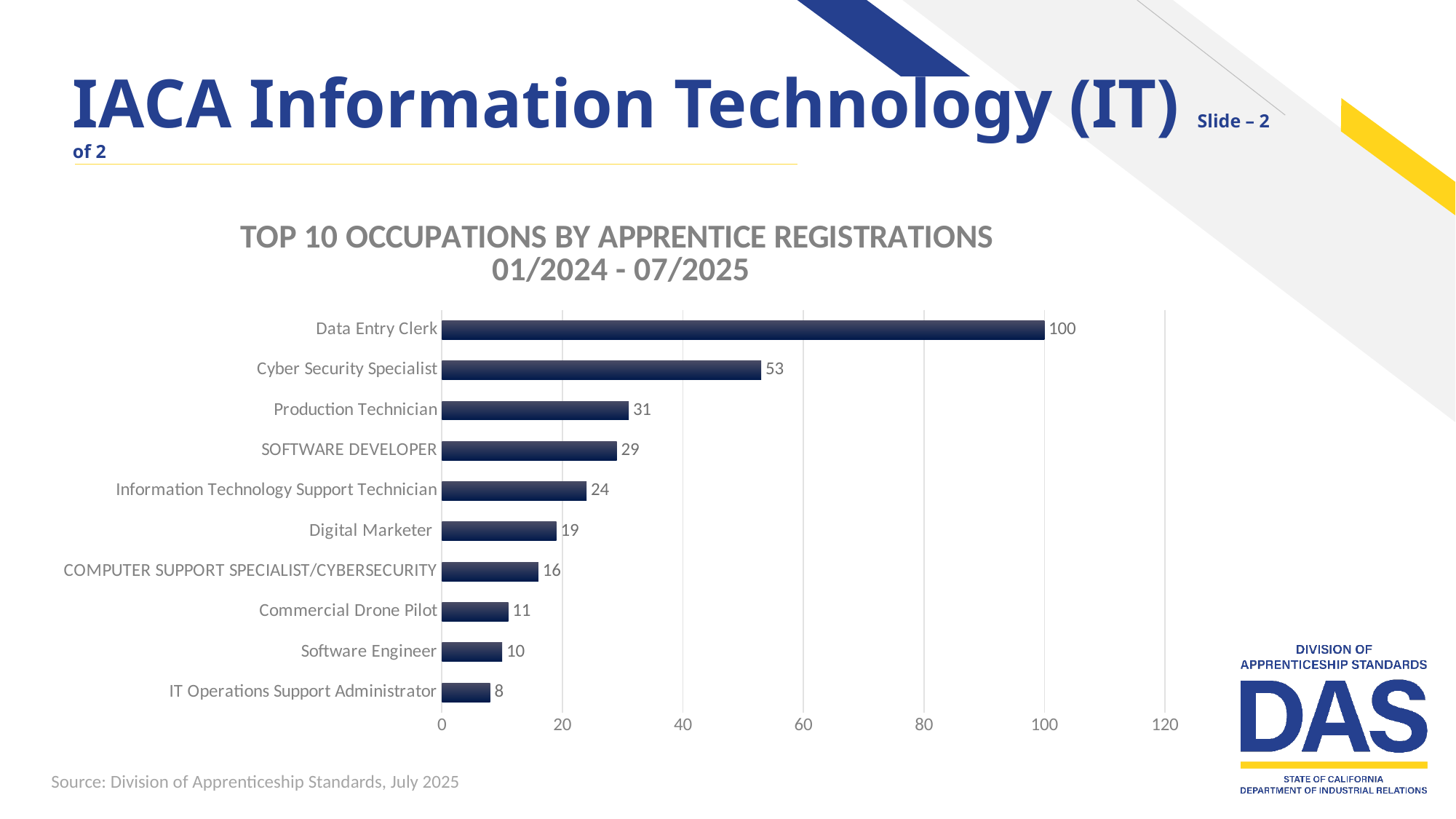
How many apprentice registrations does Data Entry Clerk have? 100 What is the difference between Data Entry Clerk and Cyber Security Specialist? 47 What kind of chart is shown on the slide? Bar chart What is the value for Commercial Drone Pilot? 11 What is the value for Cyber Security Specialist? 53 What is the difference between Production Technician and SOFTWARE DEVELOPER? 2 How many occupations are shown in the chart? 10 What is the value for Information Technology Support Technician? 24 Which has more registrations, Digital Marketer or Software Engineer? Digital Marketer What is the title of the chart? TOP 10 OCCUPATIONS BY APPRENTICE REGISTRATIONS 01/2024 - 07/2025 Which occupation has the lowest number of apprentice registrations? IT Operations Support Administrator Which occupation has the highest number of apprentice registrations? Data Entry Clerk